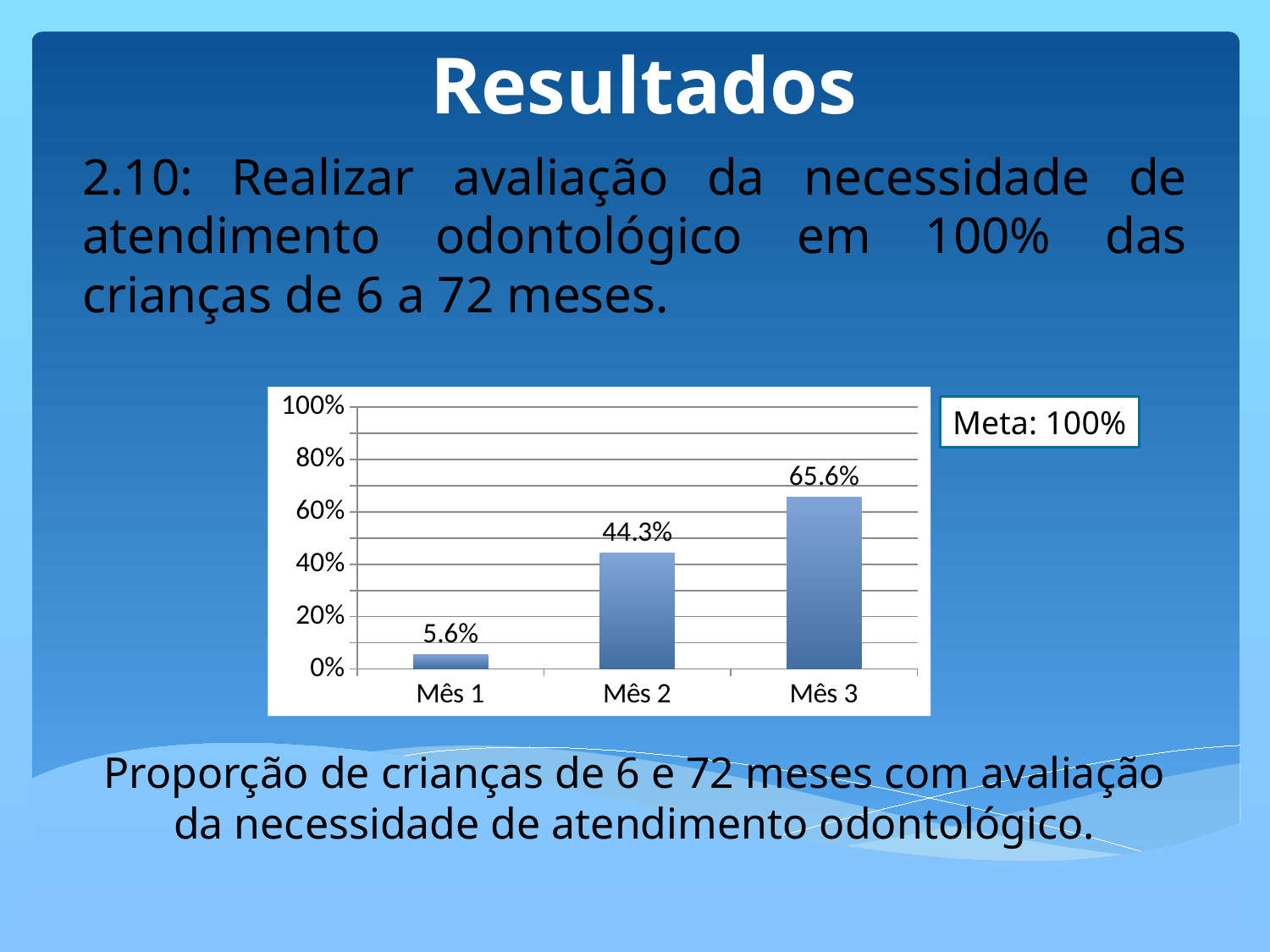
What kind of chart is shown on the slide? bar chart What is the value for Mês 2? 44.3% What is the difference between the values for Mês 3 and Mês 2? 21.3% What is the difference between the values for Mês 2 and Mês 1? 38.7% Which is larger, the value for Mês 1 or the value for Mês 2? Mês 2 Do the values rise or fall from Mês 1 to Mês 3? rise What is the value for Mês 1? 5.6% What is the value for Mês 3? 65.6% Which month has the highest value? Mês 3 Is the value for Mês 3 greater or less than 60%? greater How many months are shown on the x axis? 3 Which month has the lowest value? Mês 1